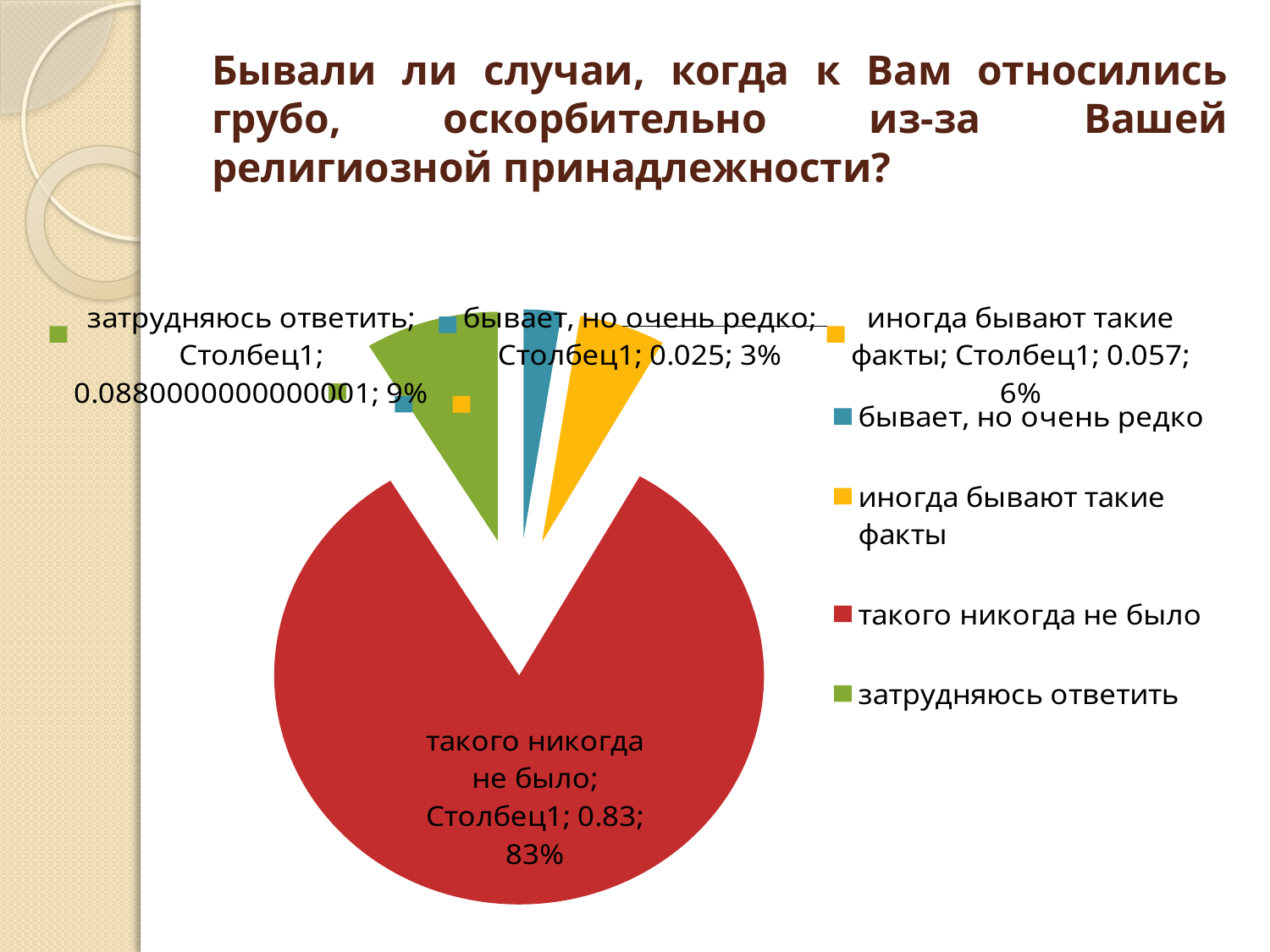
Which category has the smallest slice of the pie? бывает, но очень редко Which category has the largest slice of the pie? такого никогда не было What percentage share does the slice "иногда бывают такие факты" have? 6% What percentage share does the slice "затрудняюсь ответить" have? 9% How many entries does the legend list? 4 What percentage share does the slice "такого никогда не было" have? 83% Which is larger, the share for "затрудняюсь ответить" or the share for "иногда бывают такие факты"? затрудняюсь ответить What value is printed for "такого никогда не было" before the percentage? 0.83 What kind of chart is shown on the slide? pie chart How many slices does the pie chart have? 4 What value is printed for "бывает, но очень редко" before the percentage? 0.025